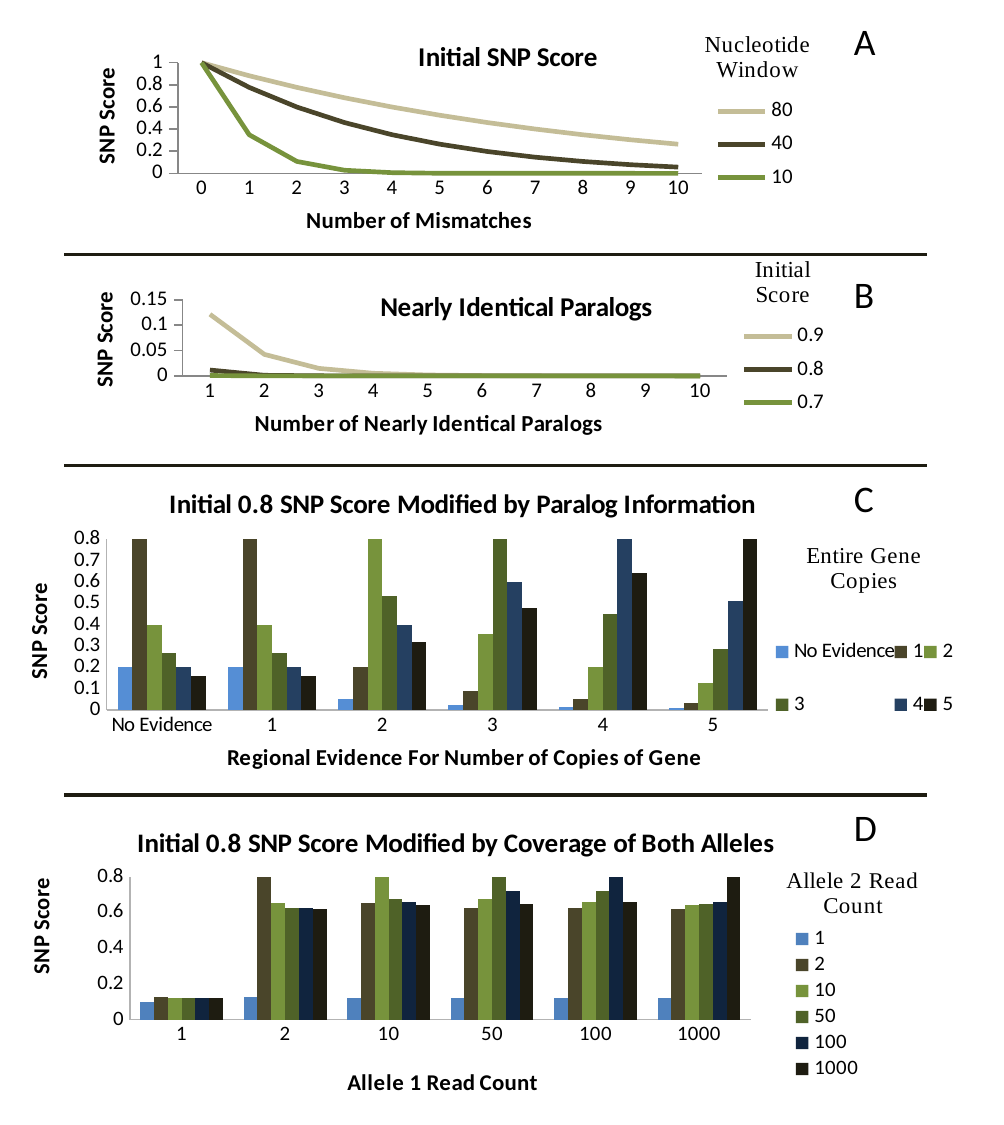
How many nucleotide window series does the legend of the 'Initial SNP Score' chart (panel A) list? 3 What kind of chart is 'Initial 0.8 SNP Score Modified by Paralog Information' (panel C)? bar chart How many Allele 1 read count categories are shown on the x axis of the 'Initial 0.8 SNP Score Modified by Coverage of Both Alleles' chart (panel D)? 6 How many 'Entire Gene Copies' series does the legend of the 'Initial 0.8 SNP Score Modified by Paralog Information' chart (panel C) list? 6 What kind of chart is the 'Initial SNP Score' chart (panel A)? line chart In the 'Initial SNP Score' chart (panel A), which nucleotide window has the highest SNP score at 5 mismatches? 80 In the 'Initial 0.8 SNP Score Modified by Coverage of Both Alleles' chart (panel D), is the SNP score for Allele 2 read count 2 at Allele 1 read count 1 greater or less than 0.2? less In the 'Initial SNP Score' chart (panel A), do the SNP scores rise or fall as the number of mismatches increases? fall In the 'Nearly Identical Paralogs' chart (panel B), which initial score line is highest at 1 nearly identical paralog? 0.9 In the 'Initial 0.8 SNP Score Modified by Paralog Information' chart (panel C), what is the SNP score for entire gene copies '1' at regional evidence 'No Evidence'? 0.8 In the 'Initial 0.8 SNP Score Modified by Paralog Information' chart (panel C), is the SNP score for the 'No Evidence' series at regional evidence 2 greater or less than 0.1? less In the 'Nearly Identical Paralogs' chart (panel B), is the SNP score for initial score 0.9 at 1 paralog greater or less than 0.1? greater